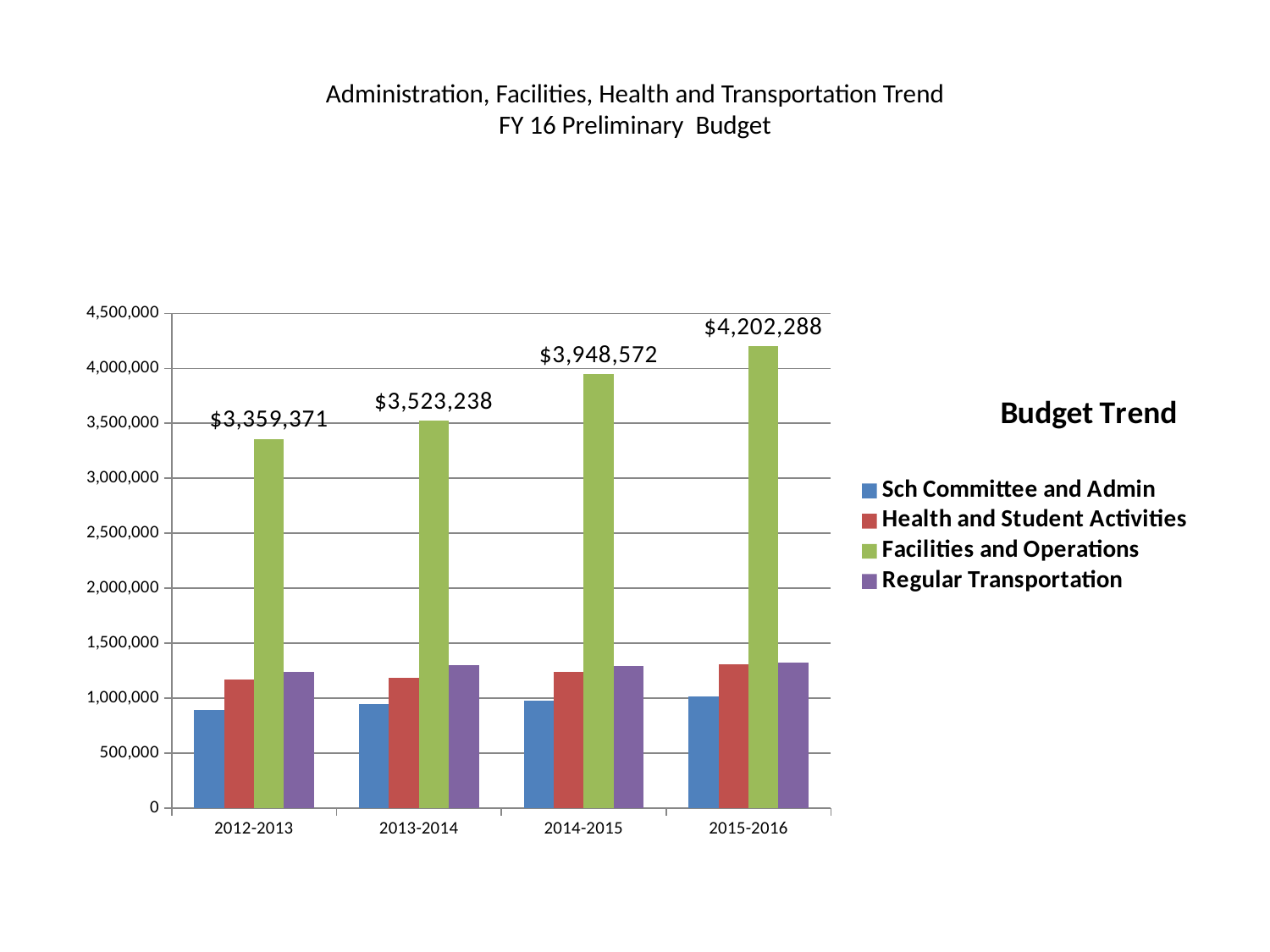
What is the value for Facilities and Operations in 2015-2016? $4,202,288 How many series does the legend list? 4 In which year is Facilities and Operations highest? 2015-2016 What is the value for Facilities and Operations in 2012-2013? $3,359,371 In 2015-2016, which is larger: Regular Transportation or Sch Committee and Admin? Regular Transportation Is the value for Sch Committee and Admin in 2012-2013 greater or less than 1,000,000? less Is the value for Regular Transportation in 2015-2016 greater or less than 1,000,000? greater What is the difference between Facilities and Operations in 2015-2016 and in 2012-2013? $842,917 In which year is Facilities and Operations lowest? 2012-2013 What is the difference between Facilities and Operations in 2014-2015 and in 2013-2014? $425,334 Does Facilities and Operations rise or fall from 2012-2013 to 2015-2016? rise What is the value for Facilities and Operations in 2013-2014? $3,523,238